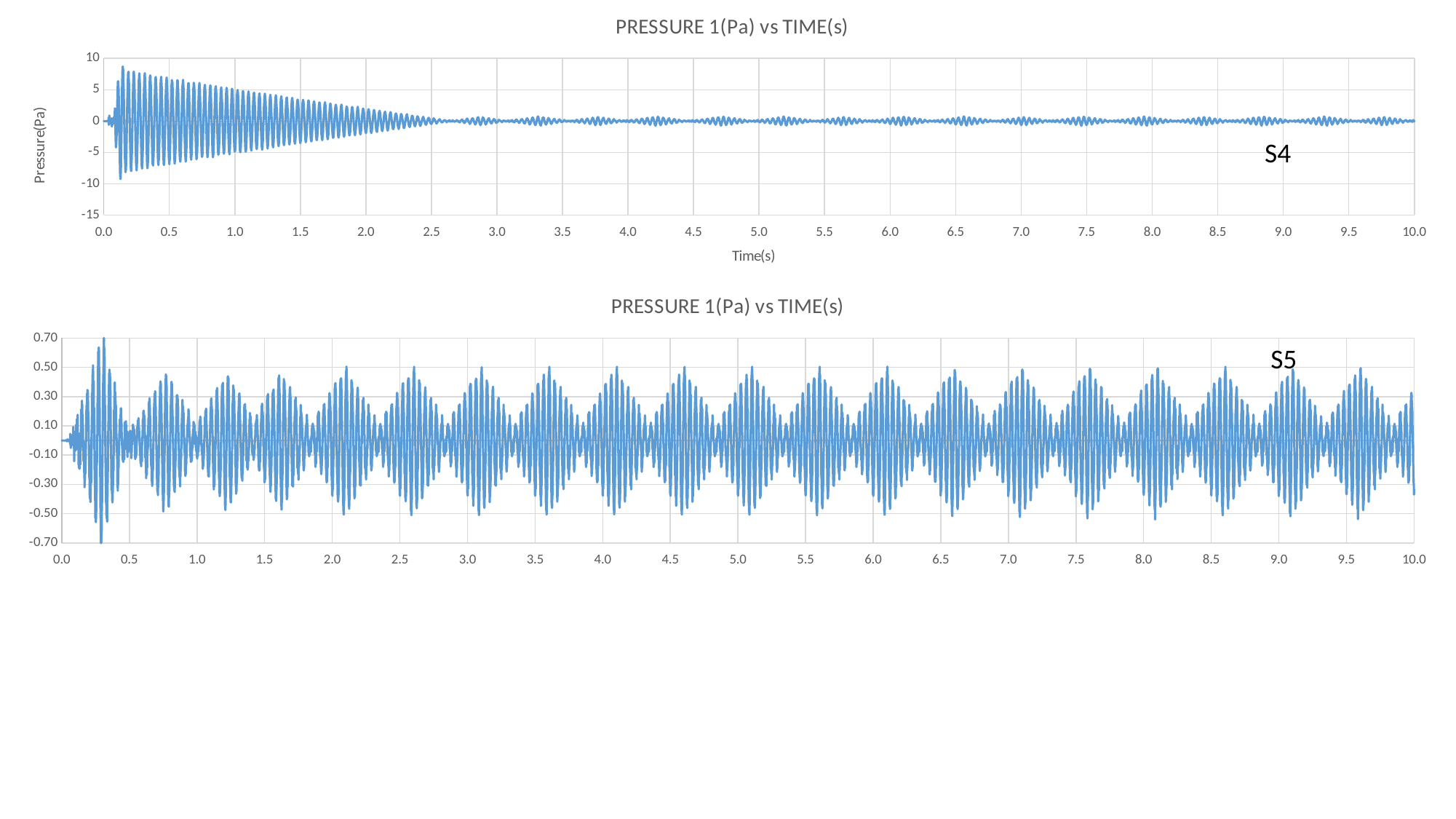
In the top chart labelled S4, is the highest pressure peak (near 0.1 s) greater or less than 5? greater In the top chart labelled S4, does the amplitude of the oscillation rise or fall as time increases from 0.0 to 2.5 s? fall What is the maximum value shown on the time axis of the bottom chart labelled S5? 10.0 What kind of chart is the bottom chart labelled S5? line chart In the bottom chart labelled S5, is the pressure peak near 1.0 s greater or less than 0.50? less What is the label on the vertical axis of the top chart labelled S4? Pressure(Pa) In the top chart labelled S4, is the pressure peak near 5.0 s greater or less than 5? less What is the title of the top chart labelled S4? PRESSURE 1(Pa) vs TIME(s) What kind of chart is the top chart labelled S4? line chart